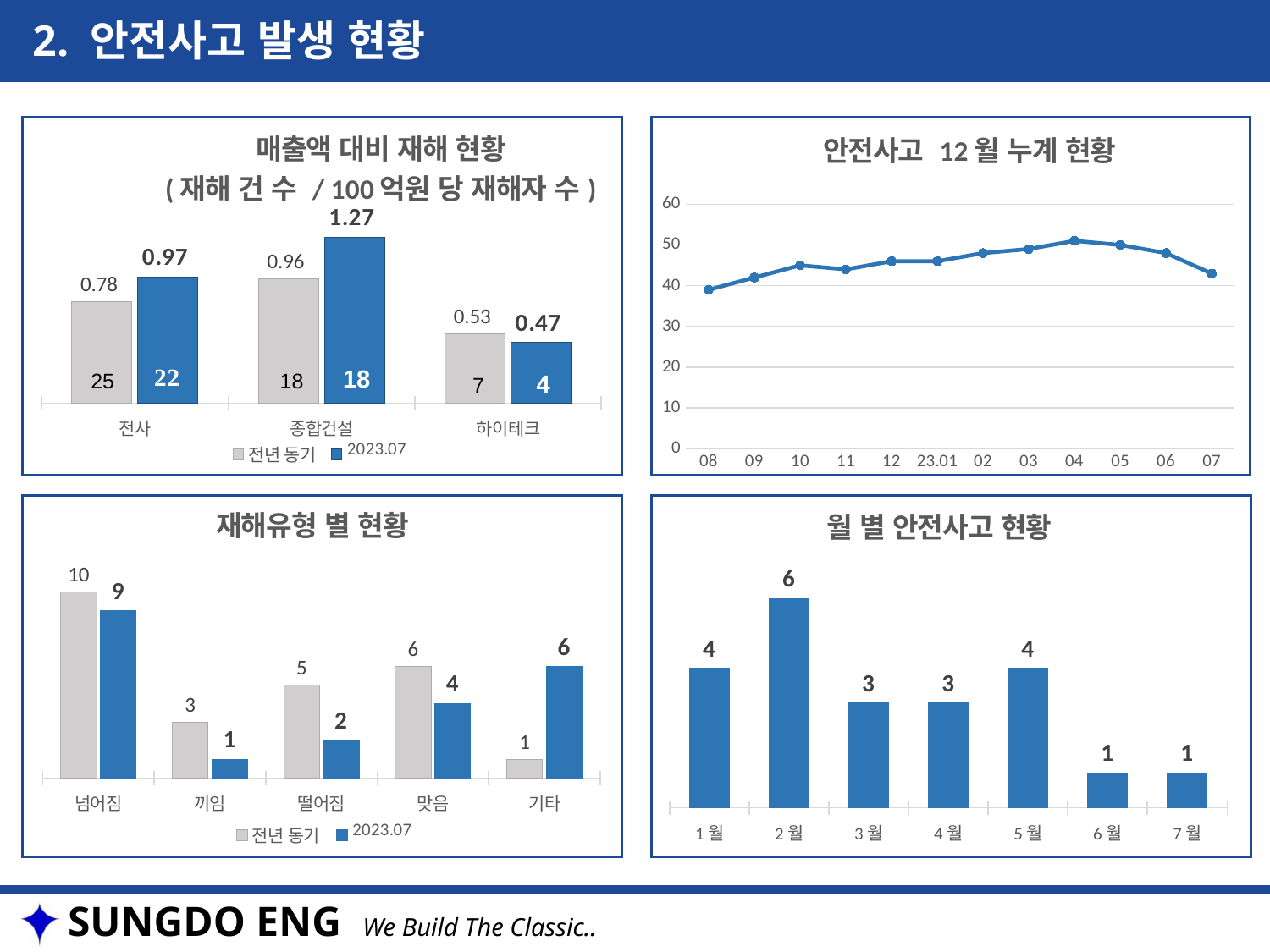
In the chart titled 월 별 안전사고 현황, which month has the highest value? 2월 In the chart titled 월 별 안전사고 현황, how many months are shown on the x axis? 7 In the chart titled 재해유형 별 현황, what is the difference between the 전년 동기 and 2023.07 values for 떨어짐? 3 In the chart titled 매출액 대비 재해 현황, what is the 전년 동기 value printed above the bar for 하이테크? 0.53 In the chart titled 재해유형 별 현황, what is the 2023.07 value for 기타? 6 In the chart titled 매출액 대비 재해 현황, what is the 2023.07 value printed above the bar for 종합건설? 1.27 In the chart titled 월 별 안전사고 현황, what is the value for 5월? 4 In the chart titled 매출액 대비 재해 현황, how many series does the legend list? 2 In the chart titled 재해유형 별 현황, which category has the highest 전년 동기 value? 넘어짐 In the chart titled 안전사고 12월 누계 현황, how many points are plotted along the x axis? 12 What kind of chart is the chart titled 안전사고 12월 누계 현황? line chart